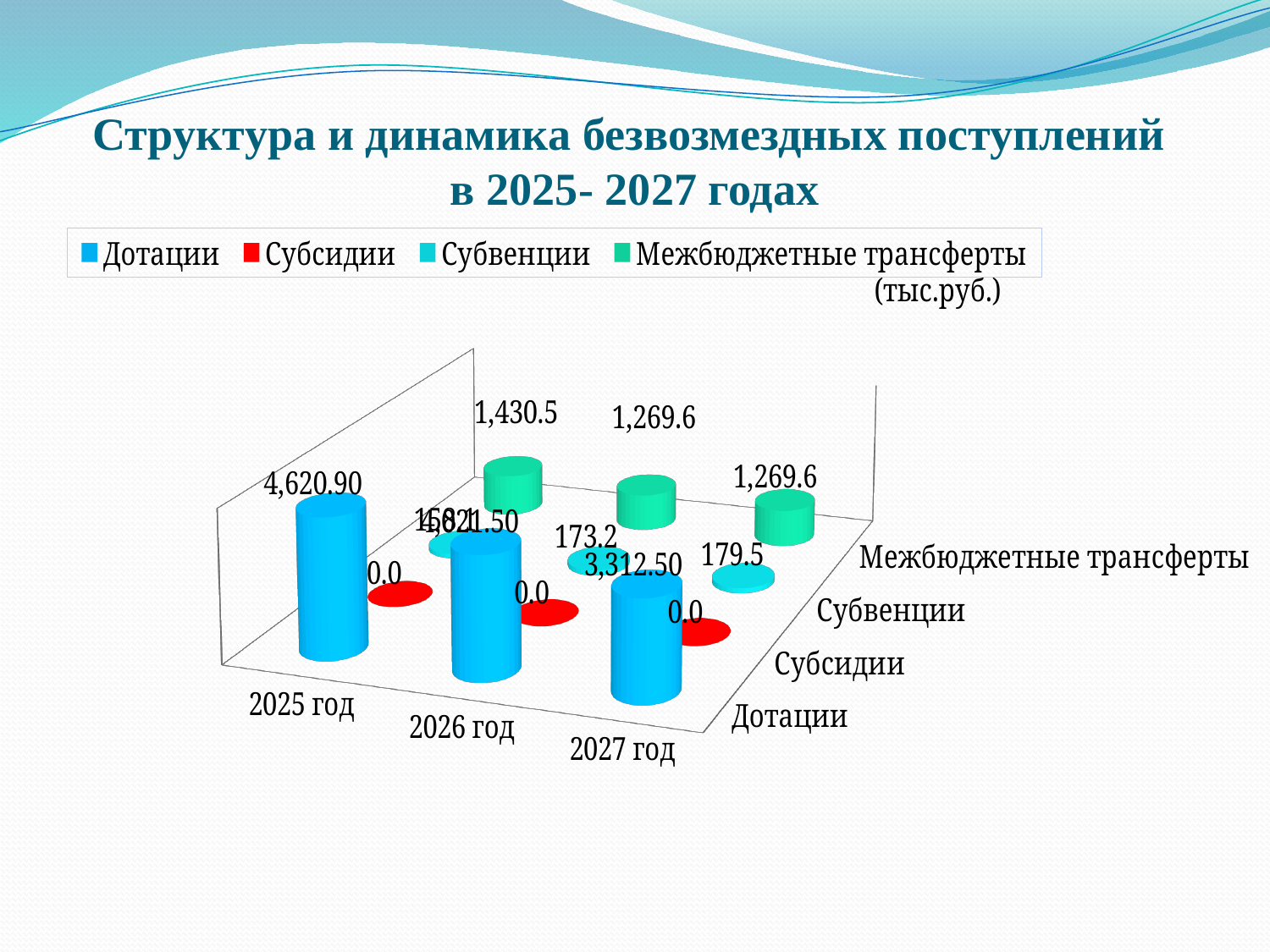
What is the difference between Межбюджетные трансферты in 2025 год and in 2026 год? 160.9 What is the value for Межбюджетные трансферты in 2025 год? 1,430.5 What is the difference between Дотации in 2025 год and in 2027 год? 1,308.40 How many series does the legend list? 4 What kind of chart is shown on the slide? bar chart In which year is the value for Межбюджетные трансферты highest? 2025 год What is the value for Субсидии in 2026 год? 0.0 What is the value for Дотации in 2027 год? 3,312.50 How many years are shown on the chart? 3 Which year has the larger value for Субвенции, 2026 год or 2027 год? 2027 год What is the value for Субвенции in 2027 год? 179.5 What is the value for Дотации in 2025 год? 4,620.90